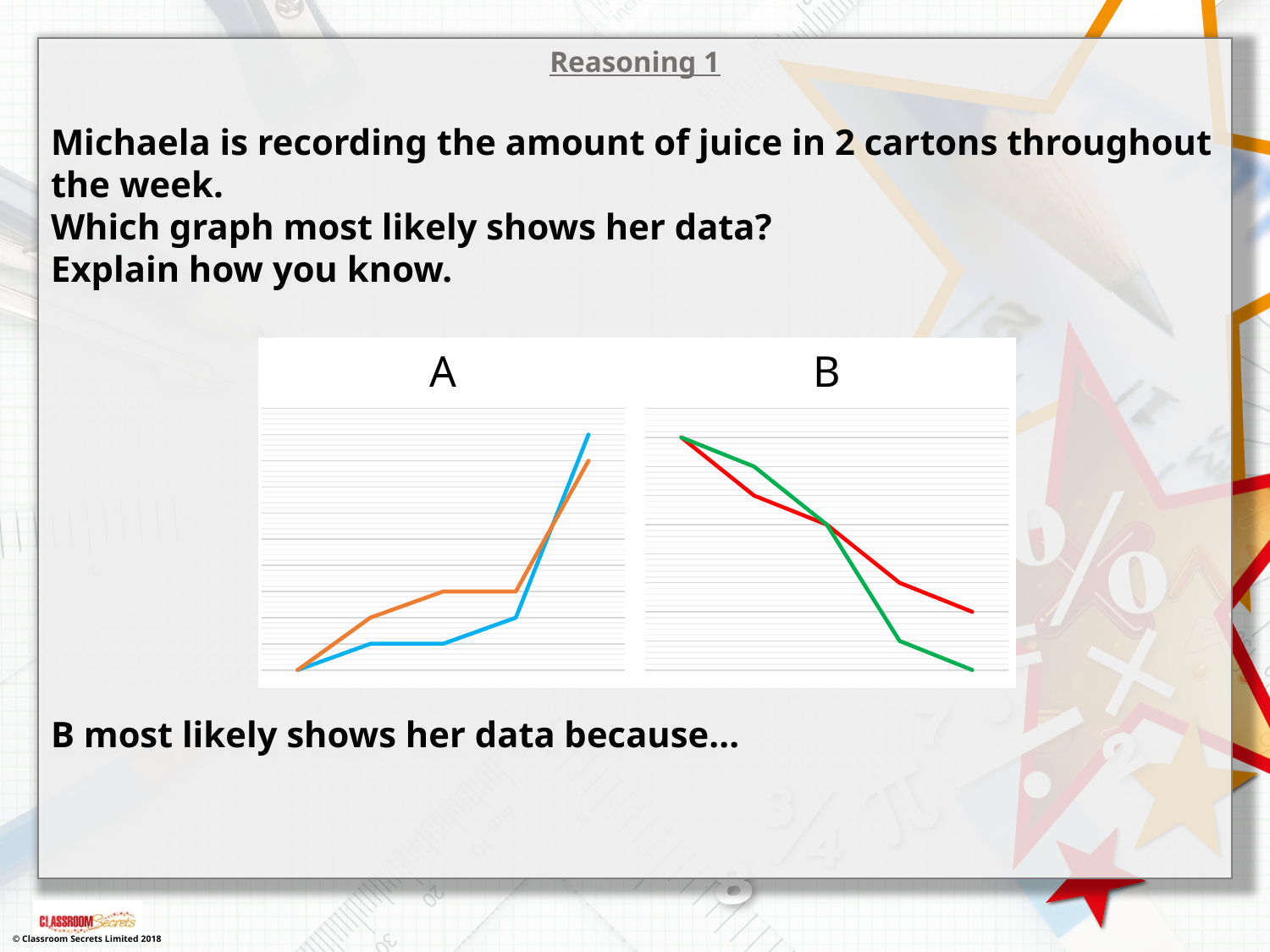
How many data points does each line in chart B have? 5 What is the title of the chart on the left? A In chart A, do the lines rise or fall from left to right? rise In chart A, which line ends higher at the right-hand side, the blue line or the orange line? blue line In chart B, do the lines rise or fall from left to right? fall How many lines are plotted in chart B? 2 In chart B, which line ends higher at the right-hand side, the red line or the green line? red line How many data points does each line in chart A have? 5 How many lines are plotted in chart A? 2 What kind of chart is chart B? line chart What colours are the two lines in chart B? green and red What kind of chart is chart A? line chart